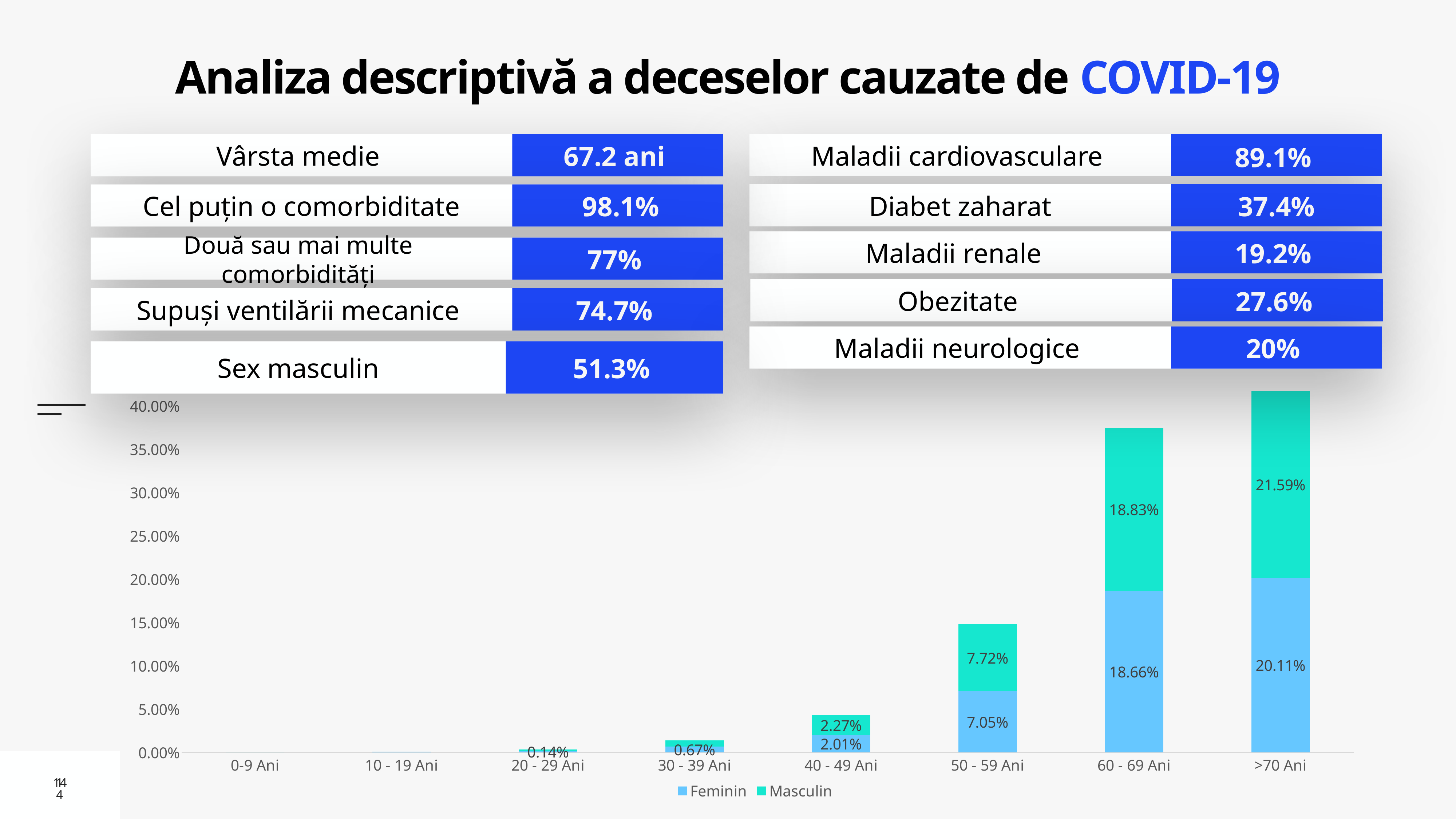
How many age groups are shown on the x axis of the chart? 8 What kind of chart is shown at the bottom of the slide? stacked bar chart What is the total of the stacked bar for the 50 - 59 Ani age group? 14.77% What is the Masculin value for the 60 - 69 Ani age group? 18.83% What is the Feminin value for the >70 Ani age group? 20.11% Which age group has the highest total stacked bar? >70 Ani Which series is shown in the lighter blue colour in the chart? Feminin What is the Masculin value for the 40 - 49 Ani age group? 2.27% Is the total stacked bar for 60 - 69 Ani greater or less than 30.00%? greater What is the Feminin value for the 50 - 59 Ani age group? 7.05% How many series does the chart legend list? 2 What is the difference between the Masculin and Feminin values for the >70 Ani age group? 1.48%